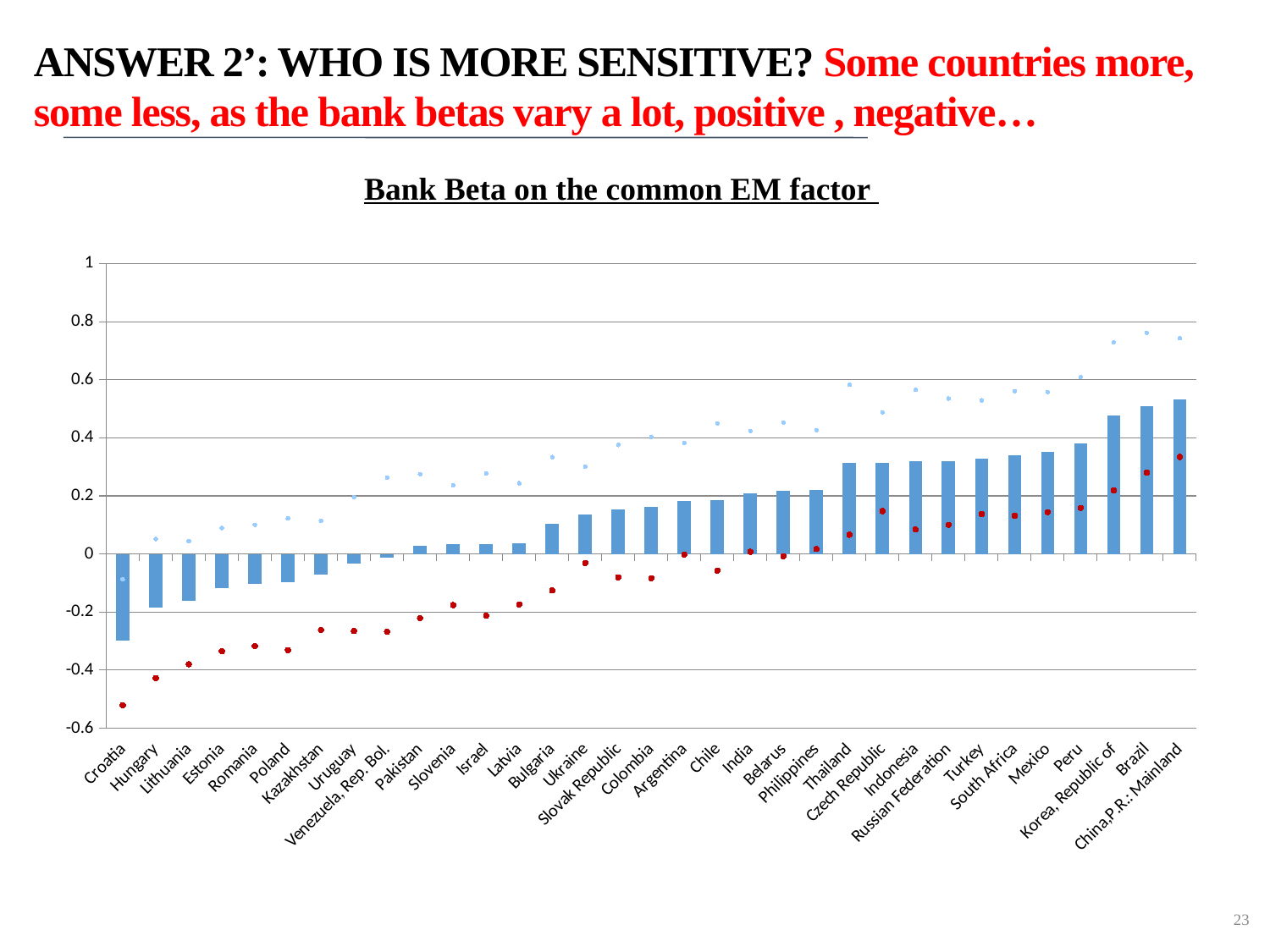
Is the bar value for Korea, Republic of greater or less than 0.4? greater What kind of chart is shown on the slide? bar chart What is the title of the chart? Bank Beta on the common EM factor Do the bar values rise or fall moving from left to right along the x axis? rise Which has the larger bar value, Mexico or Bulgaria? Mexico How many countries are shown on the x axis of the chart? 33 Is the bar value for Croatia greater or less than -0.2? less Which country has the lowest bank beta bar? Croatia Which has the larger bar value, Brazil or Peru? Brazil Is the bar value for Brazil greater or less than 0.4? greater Which country has the highest bank beta bar? China,P.R.: Mainland